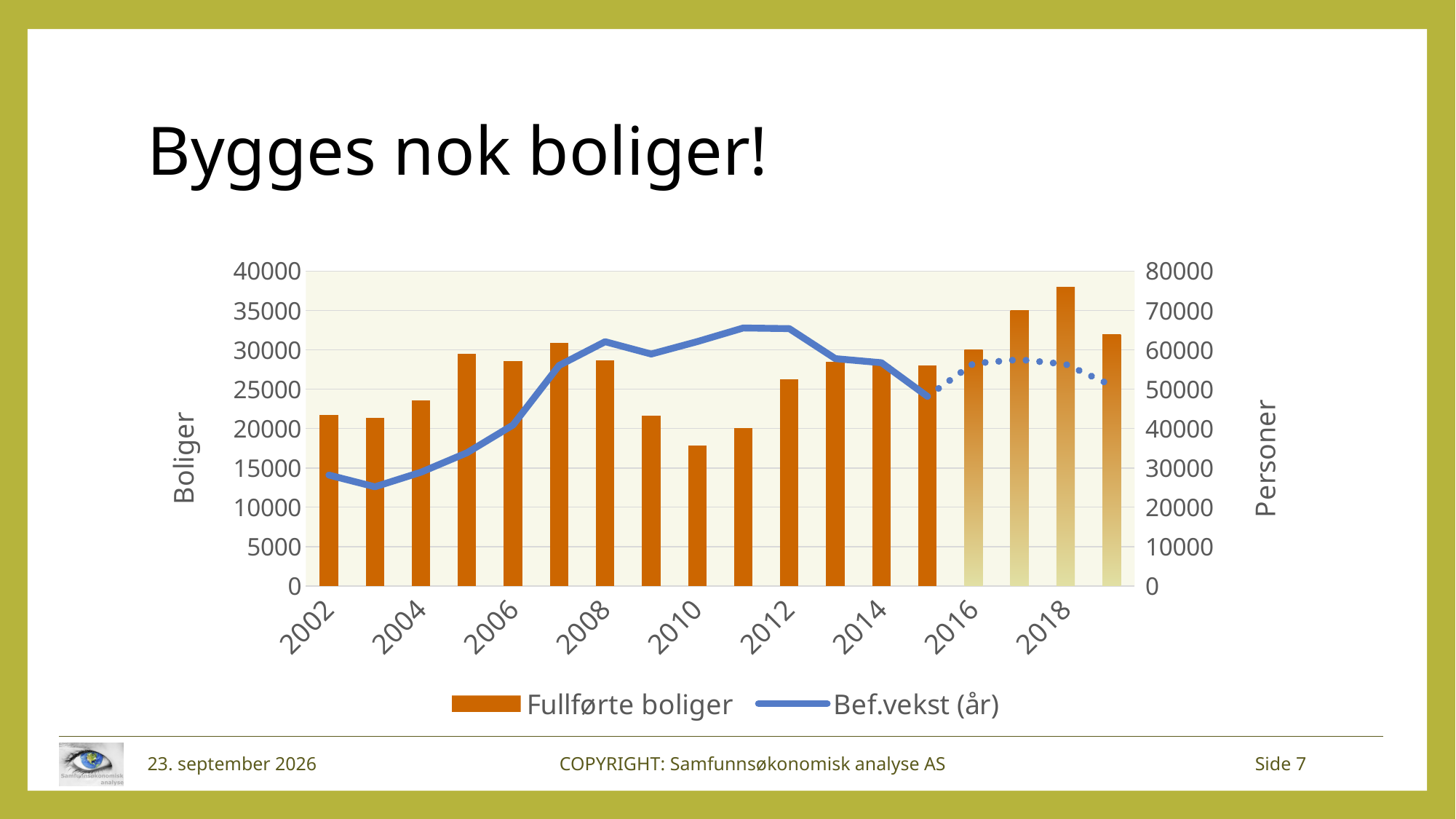
Which year has the larger Fullførte boliger bar, 2005 or 2004? 2005 In which year is the Fullførte boliger bar lowest? 2010 Is the Fullførte boliger value for 2010 greater or less than 20000? less In which year is the Fullførte boliger bar highest? 2018 Does the Bef.vekst (år) line rise or fall from 2012 to 2015? fall How many series does the legend list? 2 Is the Bef.vekst (år) value for 2003 greater or less than 30000 on the right axis? less Is the Fullførte boliger value for 2018 greater or less than 35000? greater What are the two series named in the legend? Fullførte boliger and Bef.vekst (år) What kind of chart is shown on the slide? Combination bar and line chart How many years (bars) are plotted for Fullførte boliger? 18